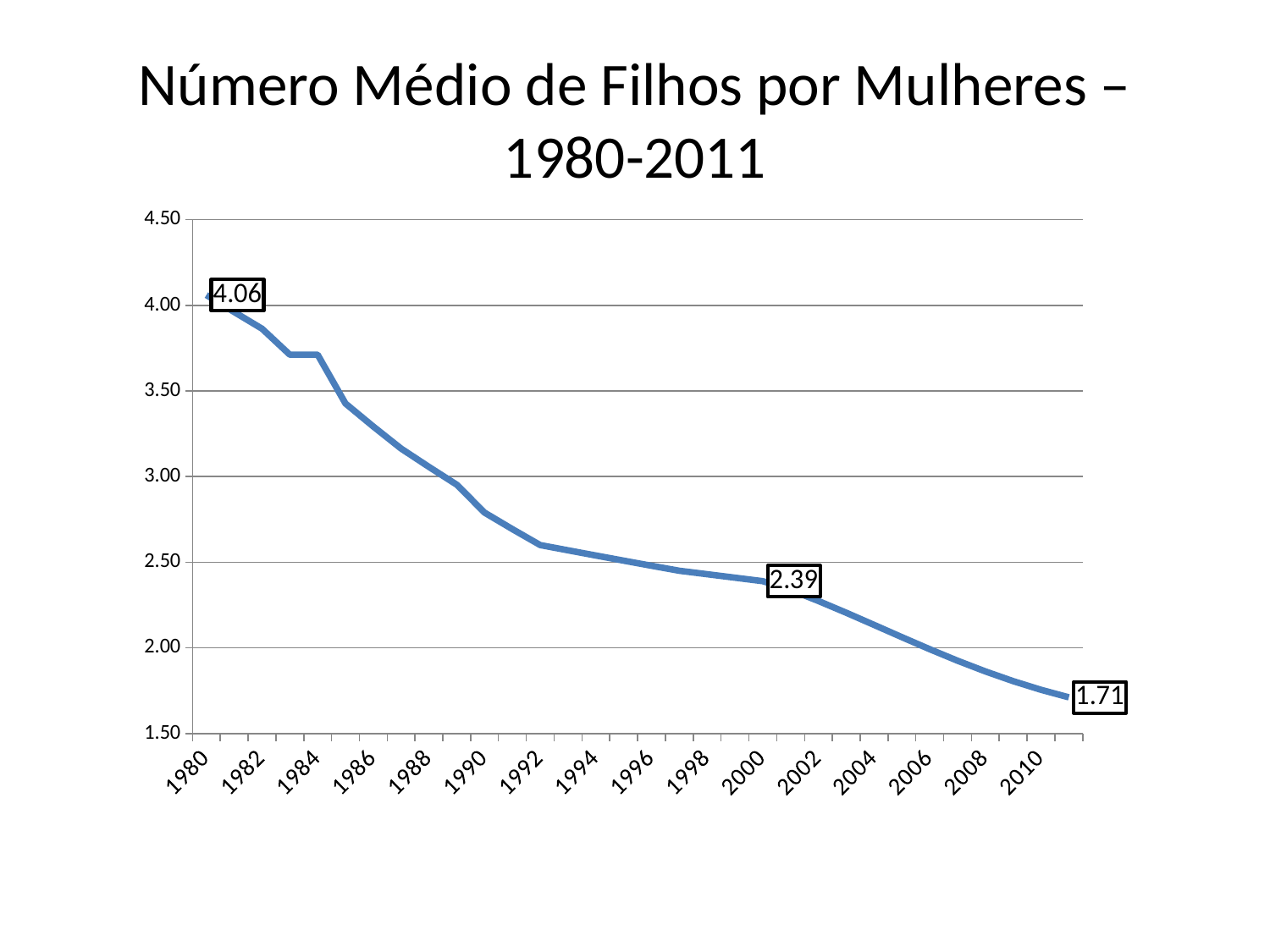
Is the value for 1986 greater or less than 3.00? greater What is the value at the last point of the line? 1.71 What is the value for 1980? 4.06 What is the value for 2000? 2.39 Which year has the highest value? 1980 What is the title of the chart? Número Médio de Filhos por Mulheres – 1980-2011 What is the difference between the value for 1980 and the value at the last point of the line? 2.35 Is the value for 1990 greater or less than 3.00? less Do the values rise or fall from 1980 to the end of the series? fall What kind of chart is shown on the slide? line chart Which is larger, the value for 1980 or the value for 2000? 1980 What is the difference between the value for 1980 and the value for 2000? 1.67